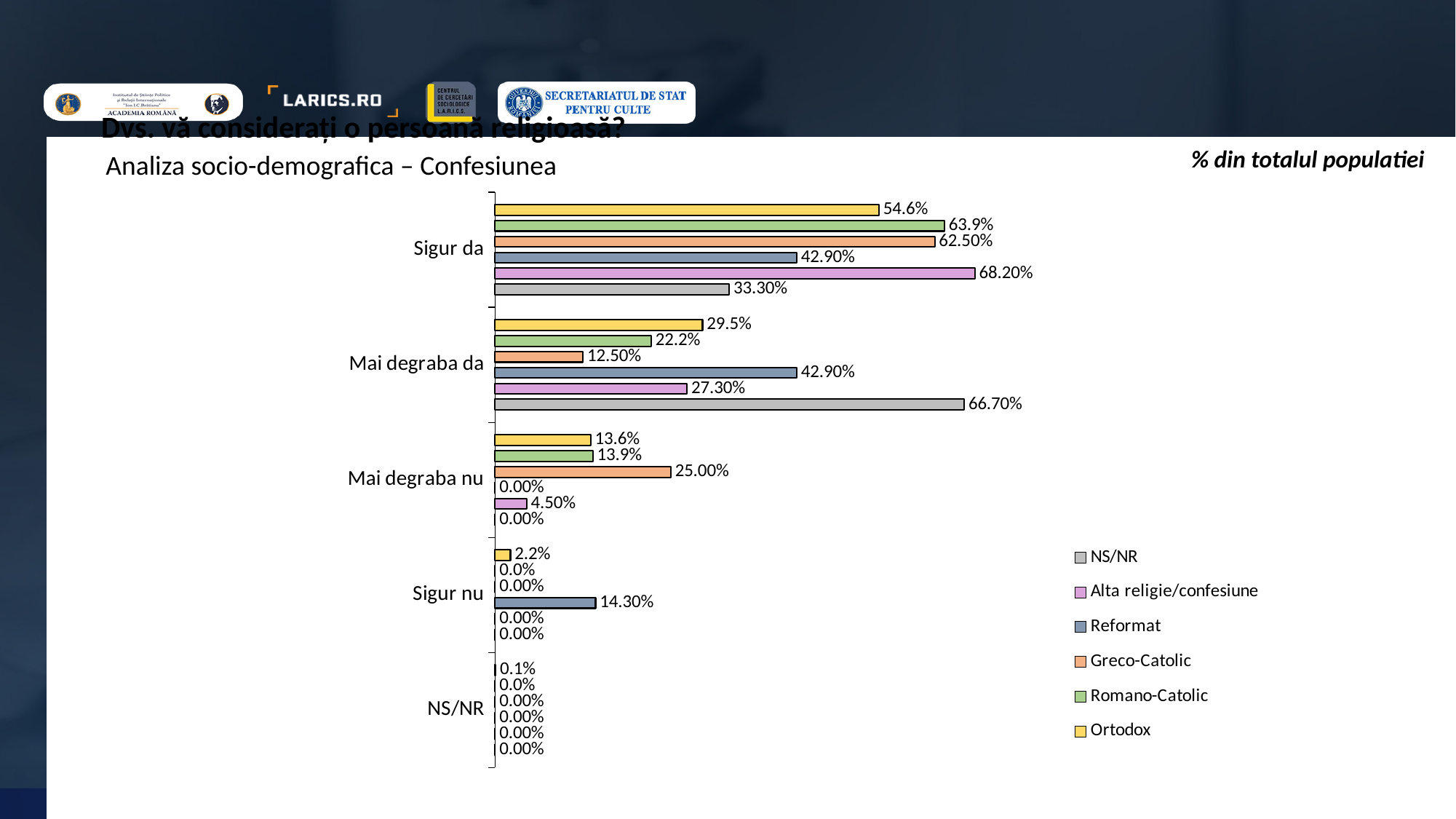
In the 'Mai degraba nu' category, which is larger: the Greco-Catolic value or the Romano-Catolic value? Greco-Catolic What is the difference between the Romano-Catolic and Ortodox values in the 'Sigur da' category? 9.3% What is the value for Alta religie/confesiune in the 'Sigur da' category? 68.20% What is the value for Ortodox in the 'Sigur da' category? 54.6% How many series does the legend list? 6 Which series has the lowest value in the 'Sigur da' category? NS/NR What kind of chart is shown on the slide? bar chart Which series has the highest value in the 'Sigur da' category? Alta religie/confesiune What is the value for Reformat in the 'Sigur nu' category? 14.30% How many response categories are shown on the vertical axis? 5 What is the subtitle of the chart shown below the question title? Analiza socio-demografica – Confesiunea What is the value for NS/NR in the 'Mai degraba da' category? 66.70%